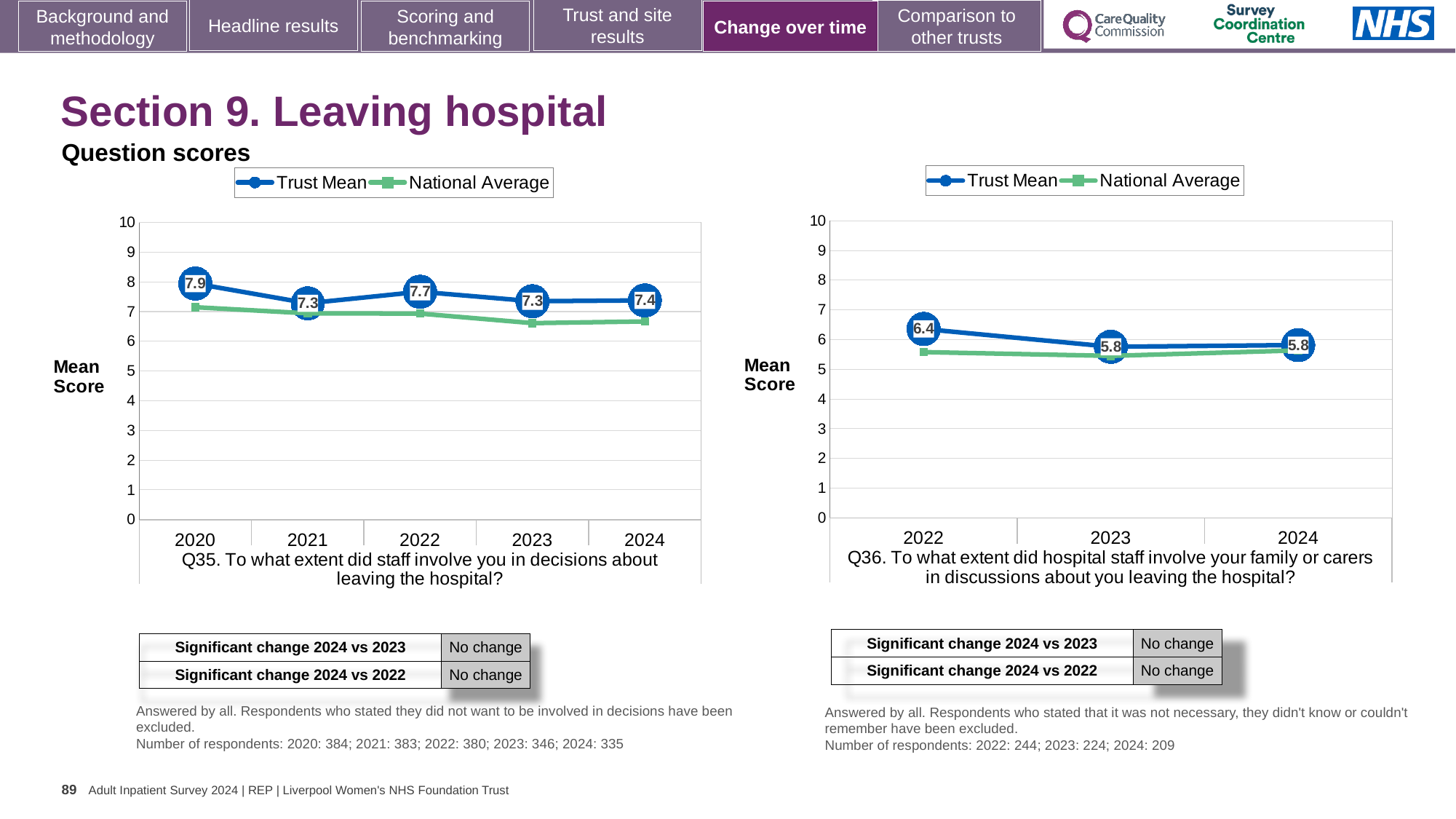
What type of chart is the Q36 chart (right)? line chart In the Q35 chart (left), what is the Trust Mean for 2020? 7.9 In the Q36 chart (right), what is the Trust Mean for 2022? 6.4 How many series does the legend of the Q35 chart (left) list? 2 In the Q35 chart (left), what is the difference between the Trust Mean in 2020 and in 2024? 0.5 In the Q35 chart (left), is the National Average for 2023 greater or less than 7? less In the Q35 chart (left), is the Trust Mean for 2022 larger or smaller than the Trust Mean for 2023? larger In the Q35 chart (left), which year has the highest Trust Mean? 2020 In the Q36 chart (right), which year has the highest Trust Mean? 2022 How many years are shown on the x axis of the Q36 chart (right)? 3 In the Q35 chart (left), what is the Trust Mean for 2024? 7.4 In the Q36 chart (right), what is the difference between the Trust Mean in 2022 and in 2023? 0.6